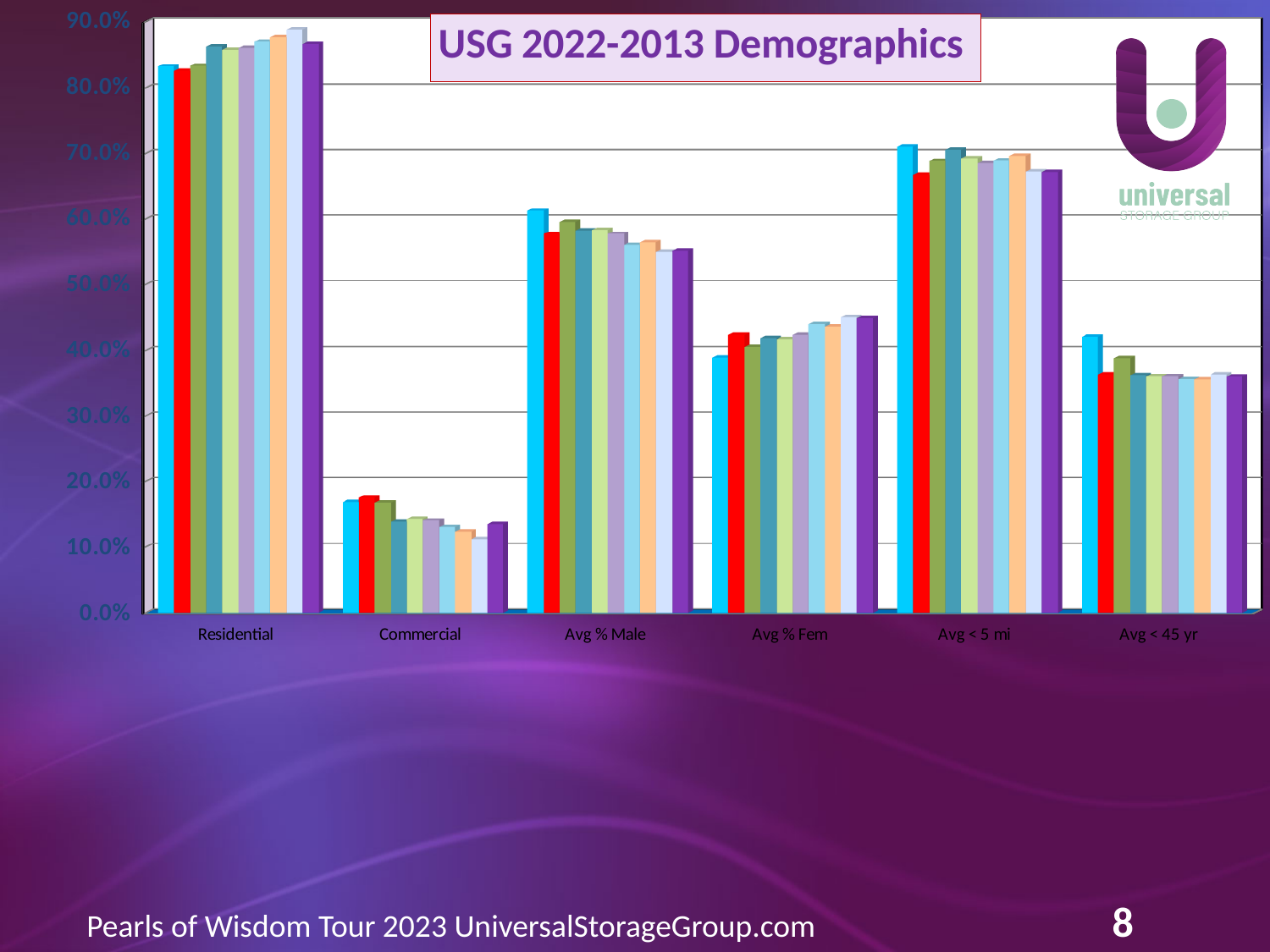
Which category has larger values, Avg % Male or Avg % Fem? Avg % Male Which category has the highest bars in the chart? Residential Are the values for Avg < 5 mi greater or less than 60.0%? greater What kind of chart is shown on the slide? Bar chart Which category has larger values, Avg < 5 mi or Avg < 45 yr? Avg < 5 mi Are the values for Commercial greater or less than 20.0%? less How many categories are shown along the x axis of the chart? 6 What is the title of the chart? USG 2022-2013 Demographics Are the values for Avg % Male greater or less than 50.0%? greater Which category has the lowest bars in the chart? Commercial